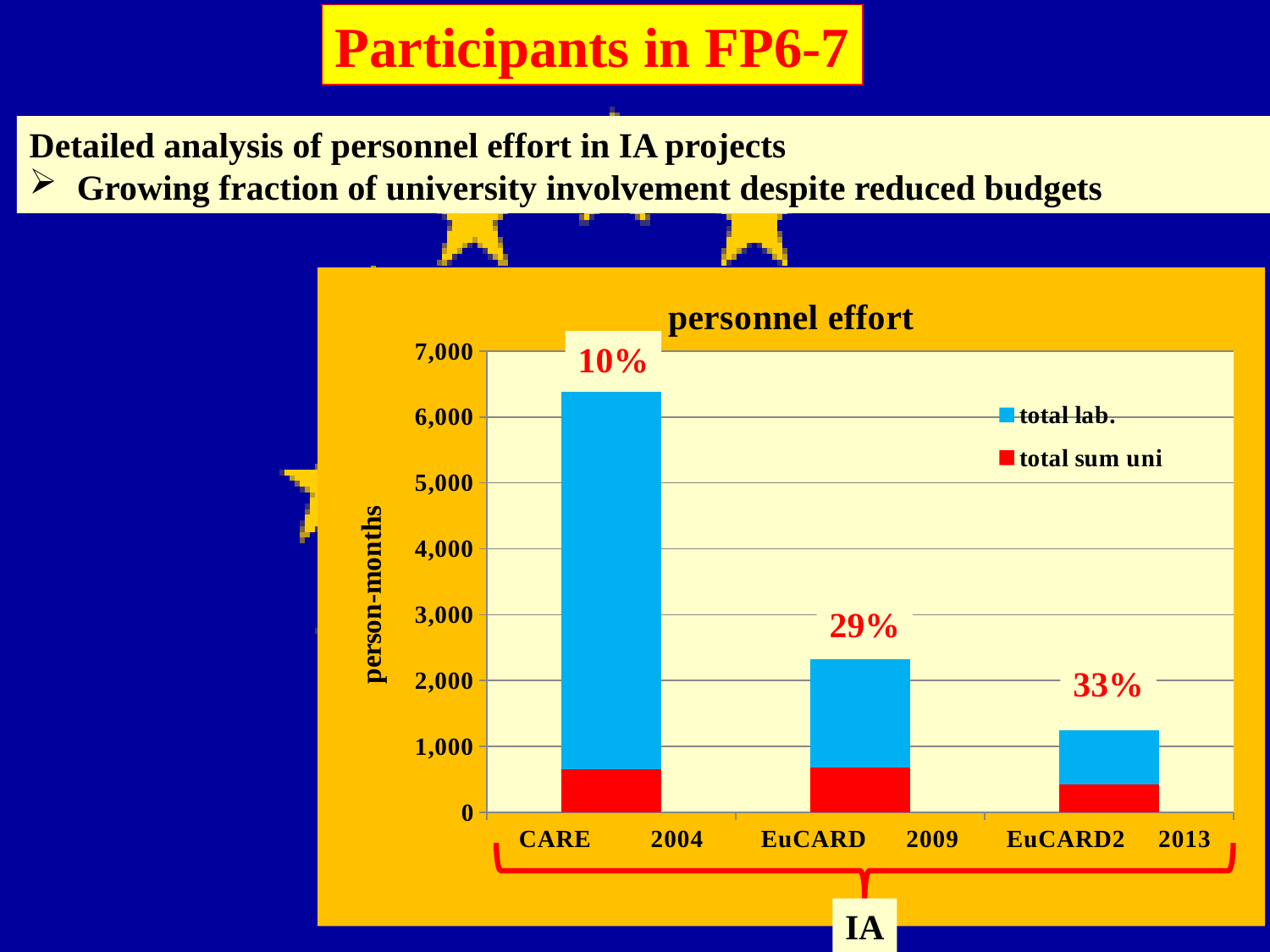
What percentage label is shown above the EuCARD bar? 29% Which project has the highest total personnel effort? CARE How many series does the chart legend list? 2 Is the total personnel effort for CARE greater or less than 6,000 person-months? greater What percentage label is shown above the EuCARD2 bar? 33% How many project categories are shown on the x axis of the chart? 3 What percentage label is shown above the CARE bar? 10% What kind of chart is shown on the slide? bar chart What is the title of the chart? personnel effort Is the total personnel effort for EuCARD2 greater or less than 2,000 person-months? less Which project has the lowest total personnel effort? EuCARD2 Does the total personnel effort rise or fall from CARE to EuCARD2 along the x axis? fall